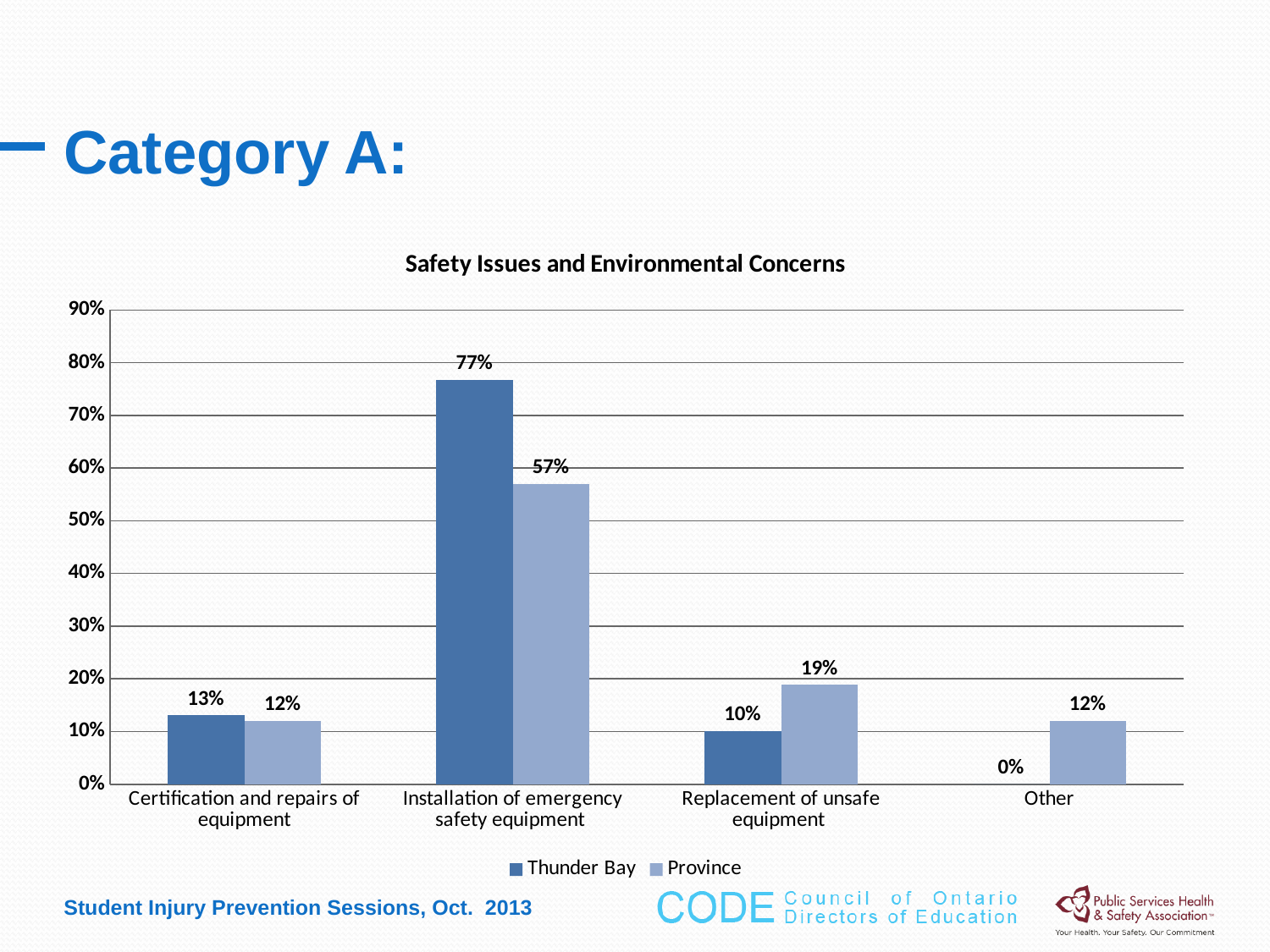
What kind of chart is shown on the slide? Bar chart How many series does the legend list? 2 What is the Thunder Bay value for Installation of emergency safety equipment? 77% Is the Province value for Installation of emergency safety equipment greater or less than 50%? greater Which category has the highest Province value? Installation of emergency safety equipment For Replacement of unsafe equipment, which series has the larger value, Thunder Bay or Province? Province Which category has the lowest Thunder Bay value? Other How many categories are shown on the x axis? 4 What is the Province value for Replacement of unsafe equipment? 19% What is the title of the chart? Safety Issues and Environmental Concerns What is the difference between the Thunder Bay and Province values for Installation of emergency safety equipment? 20% What is the Thunder Bay value for Other? 0%